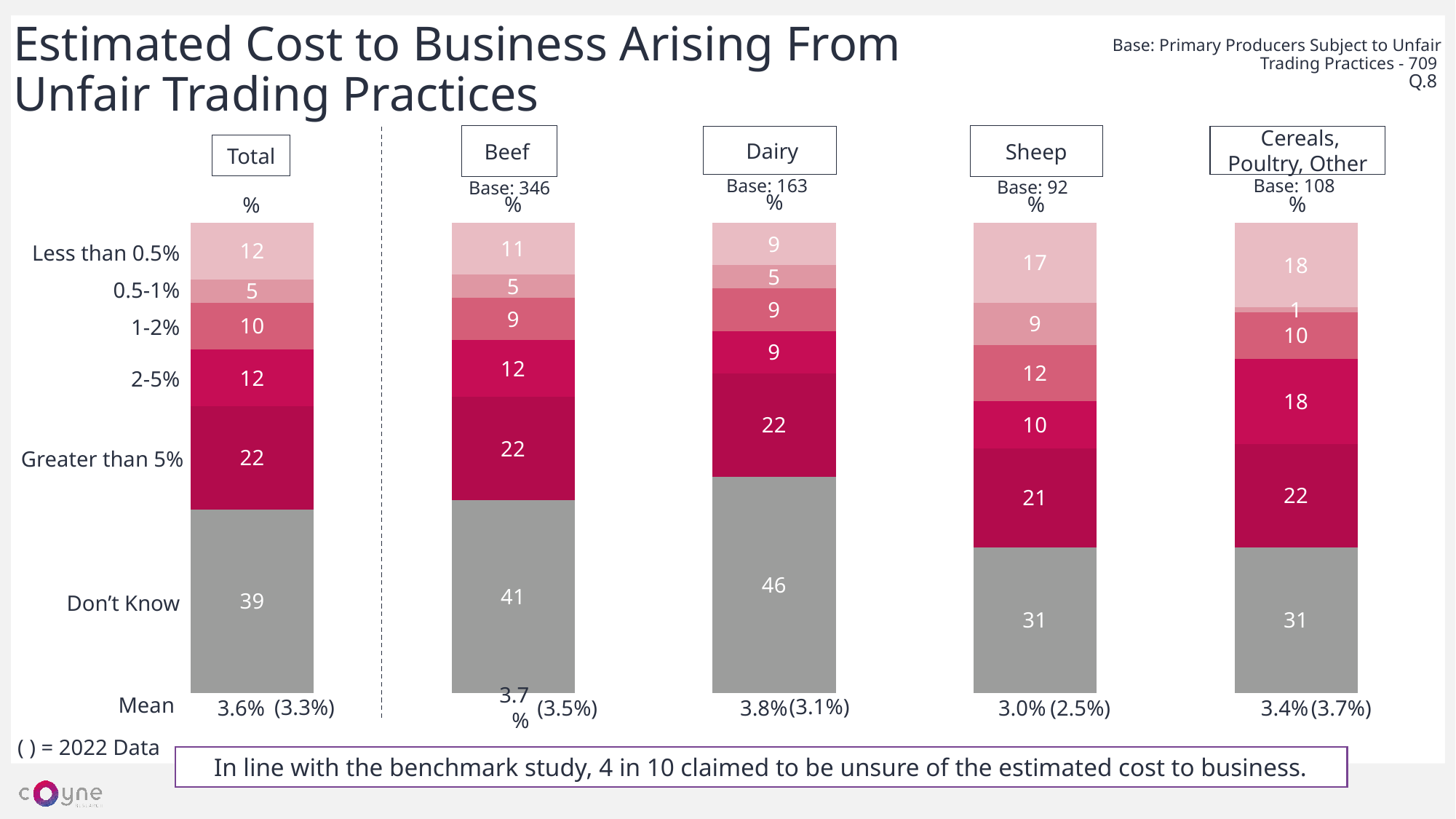
What was the 2022 mean estimated cost for Dairy producers? 3.1% How much higher is the "Don't Know" value for Dairy than for Total? 7 Which group has the lowest value for "Less than 0.5%"? Dairy What percentage of Sheep producers estimated a cost of "Greater than 5%"? 21 What is the base (number of respondents) for the Beef bar? 346 What is the value for "0.5-1%" in the Cereals, Poultry, Other bar? 1 How many cost categories are shown in each stacked bar? 6 What kind of chart is used on this slide? Stacked bar chart Which group has the highest "Don't Know" percentage? Dairy Which has the larger "Less than 0.5%" value, Sheep or Beef? Sheep What is the mean estimated cost for Sheep producers? 3.0% What percentage of Dairy producers answered "Don't Know"? 46